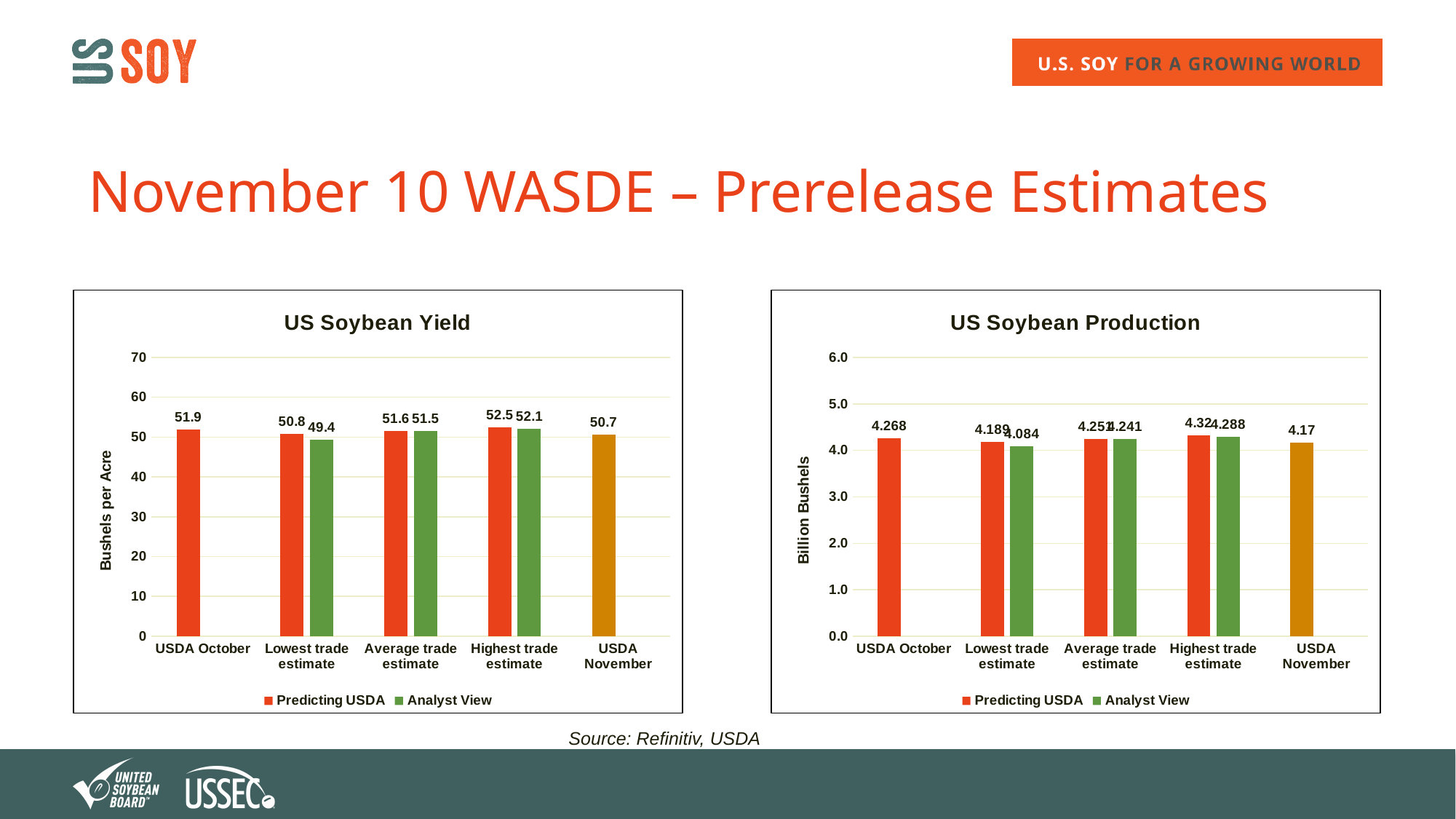
In the US Soybean Production chart, which is larger: the USDA October value or the USDA November value? USDA October In the US Soybean Production chart, what is the value for USDA October? 4.268 What kind of chart is the US Soybean Yield chart? Bar chart In the US Soybean Production chart, what is the Analyst View value for the Lowest trade estimate? 4.084 In the US Soybean Yield chart, which category has the highest Predicting USDA value? Highest trade estimate In the US Soybean Yield chart, what is the Analyst View value for the Lowest trade estimate? 49.4 How many series does the legend of the US Soybean Production chart list? 2 How many categories are shown on the x axis of the US Soybean Production chart? 5 In the US Soybean Yield chart, what is the value for USDA October? 51.9 In the US Soybean Yield chart, what is the value for USDA November? 50.7 In the US Soybean Production chart, what is the value for USDA November? 4.17 In the US Soybean Yield chart, what is the difference between the Predicting USDA and Analyst View values for the Lowest trade estimate? 1.4